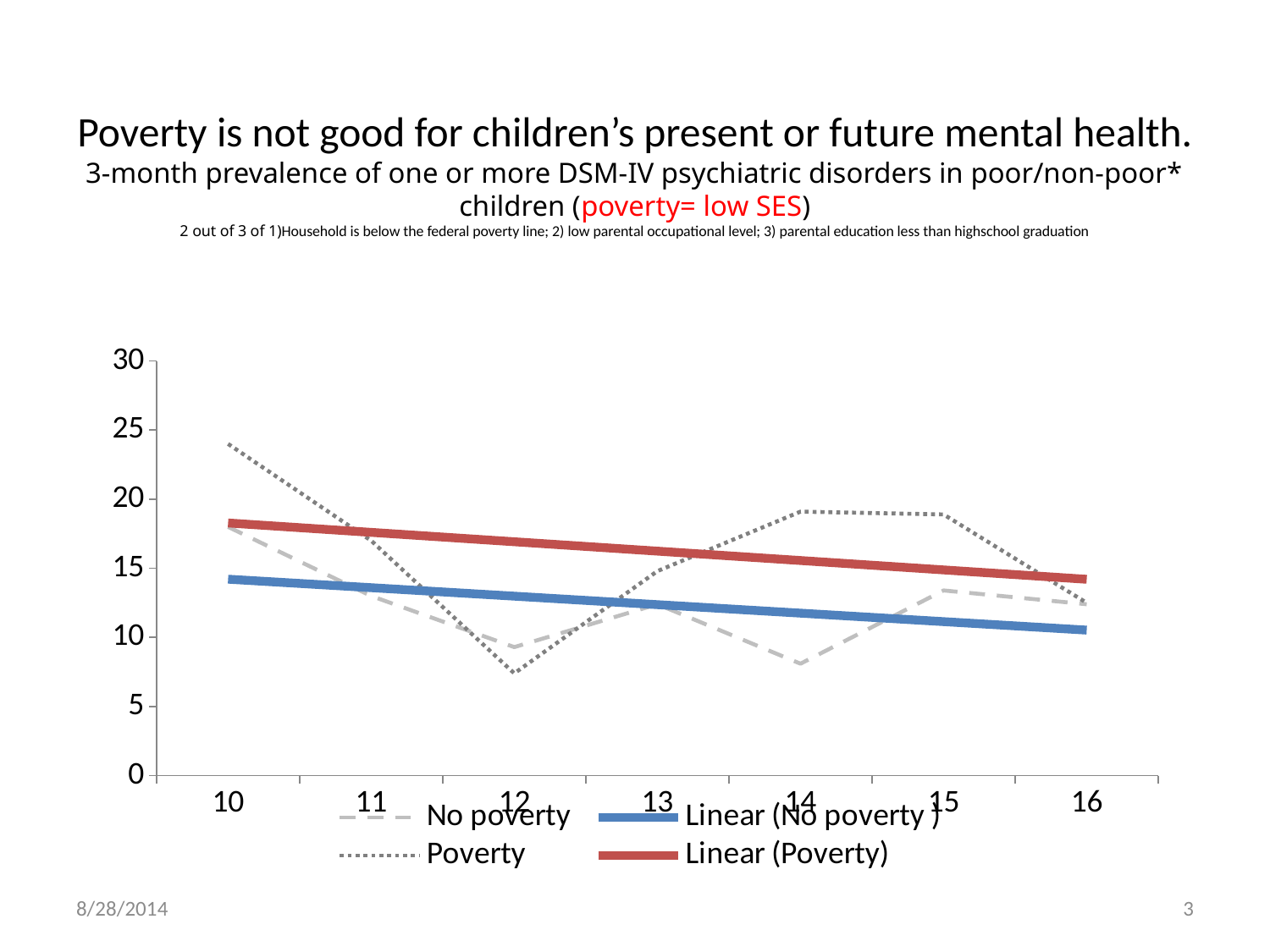
At age 14, which series has the larger value, Poverty or No poverty? Poverty Does the Linear (No poverty) trendline rise or fall across the x axis? fall At which age does the Poverty series reach its lowest value? 12 Is the Poverty value at age 10 greater or less than 20? greater How many age points are shown along the x axis of the chart? 7 Is the Poverty value at age 14 greater or less than 15? greater Is the No poverty value at age 14 greater or less than 10? less Does the Linear (Poverty) trendline rise or fall from age 10 to age 16? fall What kind of chart is shown on the slide? line chart At which age does the Poverty series reach its highest value? 10 How many entries does the chart legend list? 4